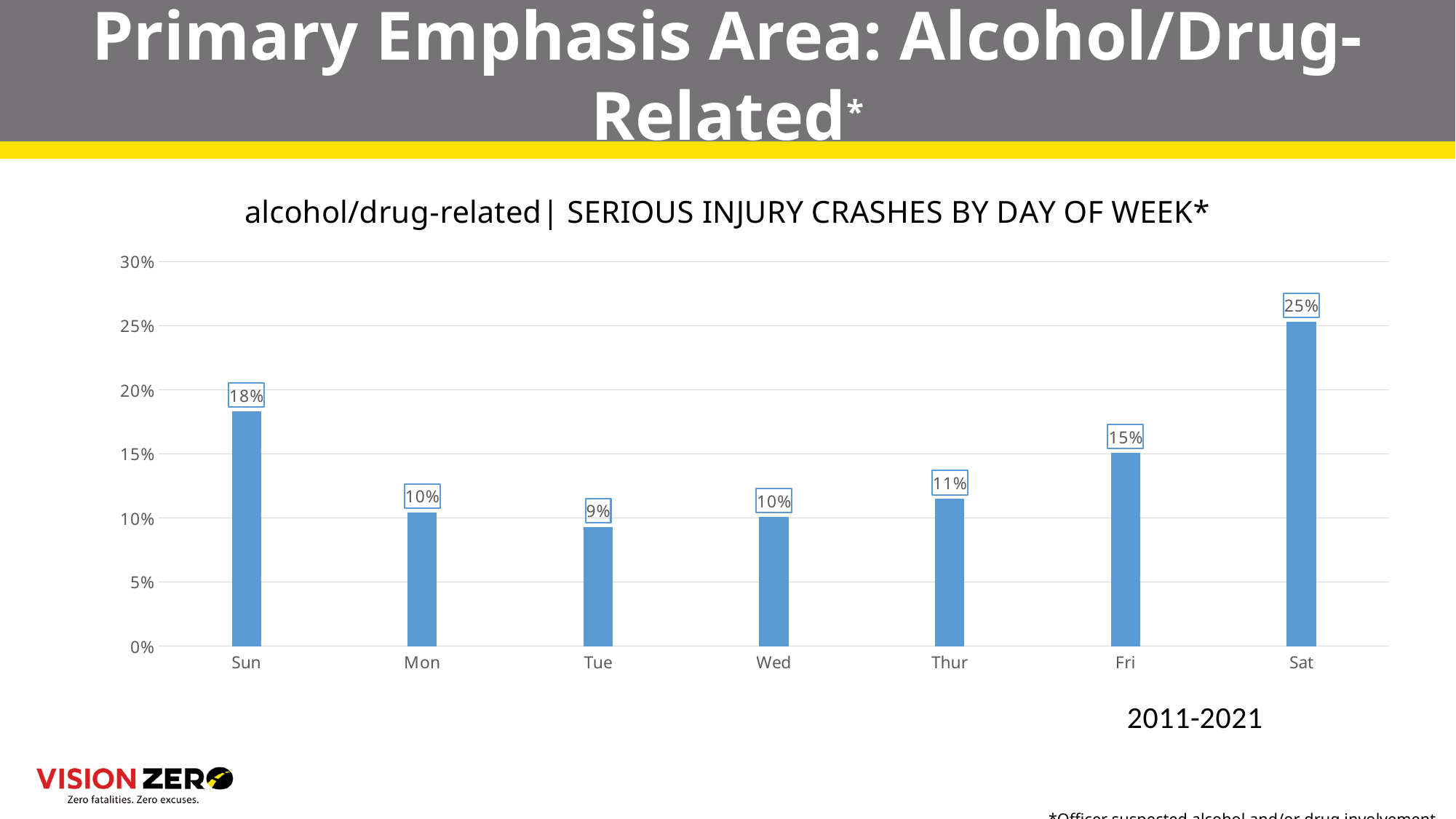
What is the value for Sun? 18% Which day of the week has the highest share of serious injury crashes? Sat What kind of chart is shown on the slide? Bar chart What time period does the chart cover, as noted below the chart? 2011-2021 Which day of the week has the lowest share of serious injury crashes? Tue What is the value for Thur? 11% What is the value for Sat? 25% Which is larger, the value for Sun or the value for Fri? Sun What is the difference between the values for Sun and Mon? 8% What is the difference between the values for Sat and Fri? 10% How many days of the week are shown on the x axis? 7 Is the value for Sat greater or less than 20%? greater